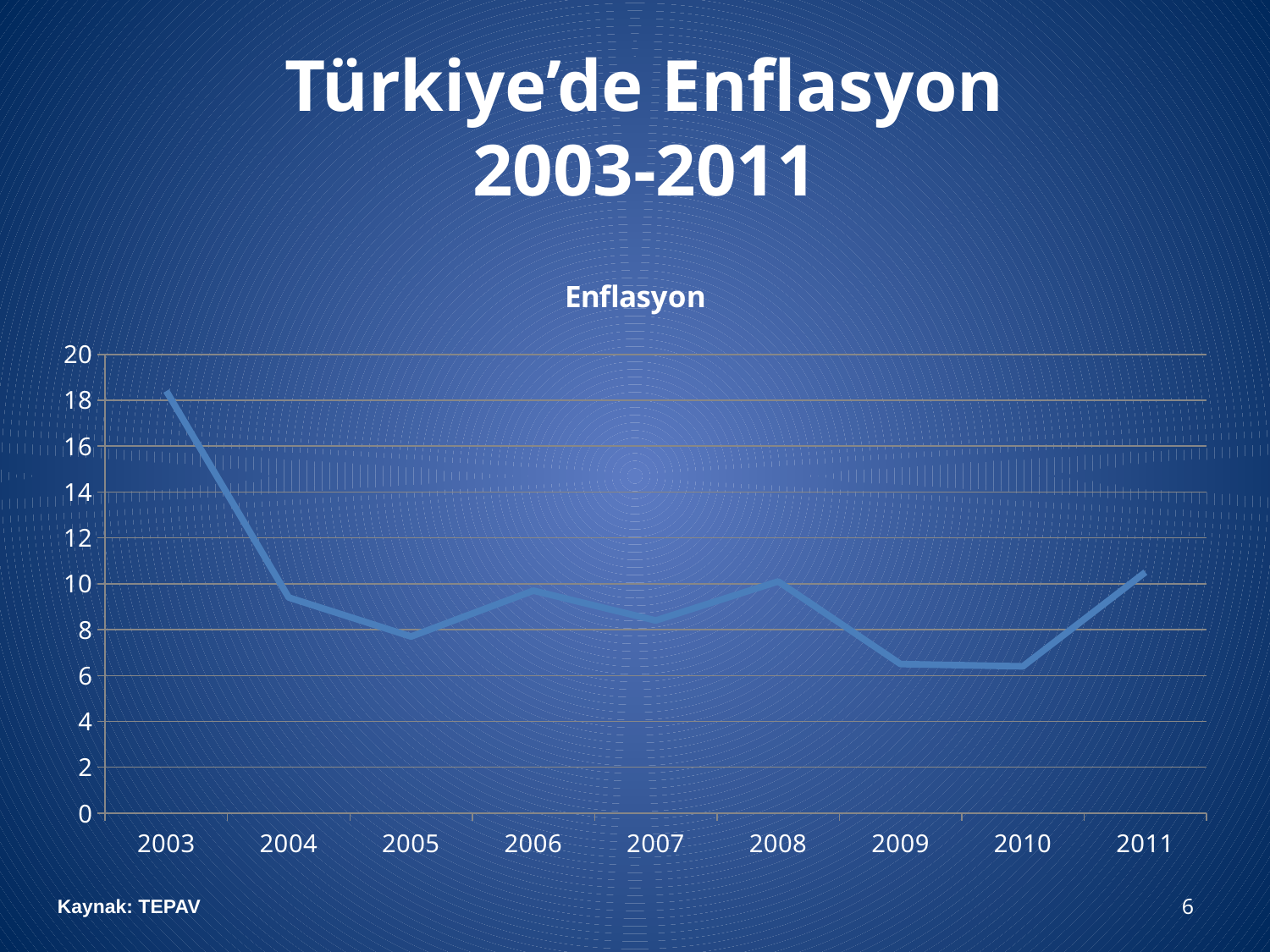
Does the line rise or fall from 2003 to 2005? fall Which year has the highest inflation value in the chart? 2003 Is the value for 2011 greater or less than 8? greater Is the value for 2003 greater or less than 16? greater Which year has the larger value, 2008 or 2009? 2008 Is the value for 2004 greater or less than 10? less What is the title of the chart? Enflasyon Which year has the larger value, 2010 or 2011? 2011 How many years are plotted on the x axis of the chart? 9 What kind of chart is shown on the slide? line chart